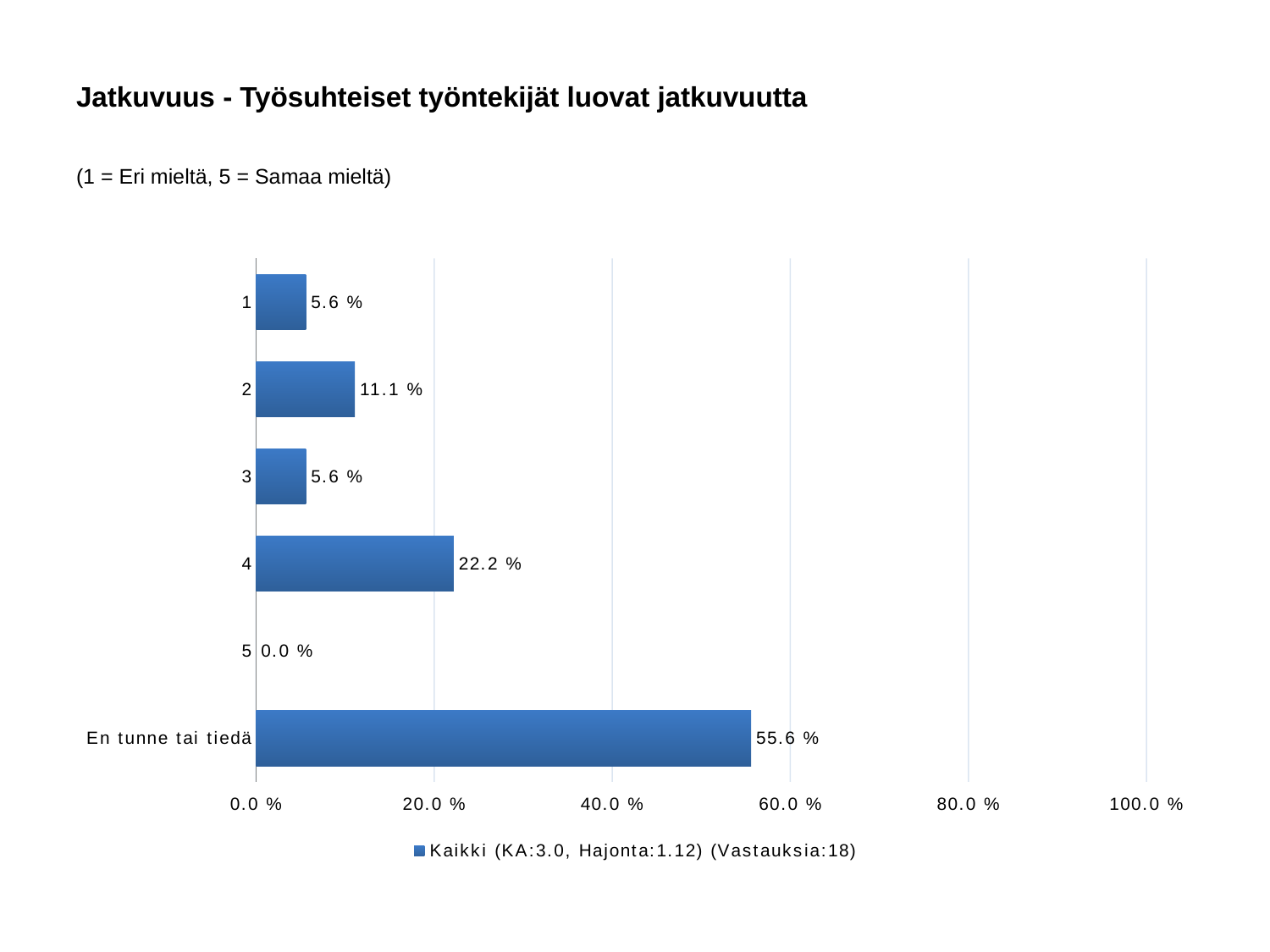
What is the legend entry of the chart? Kaikki (KA:3.0, Hajonta:1.12) (Vastauksia:18) What kind of chart is shown on the slide? bar chart How many categories are shown on the chart? 6 Which is larger, the value for category 2 or the value for category 4? 4 What is the value for category 5? 0.0 % What is the value for category 4? 22.2 % Is the value for "En tunne tai tiedä" greater or less than 40.0 %? greater What is the value for "En tunne tai tiedä"? 55.6 % What is the difference between the values for "En tunne tai tiedä" and category 4? 33.4 % What is the value for category 2? 11.1 % Which category has the highest value? En tunne tai tiedä Which category has the lowest value? 5